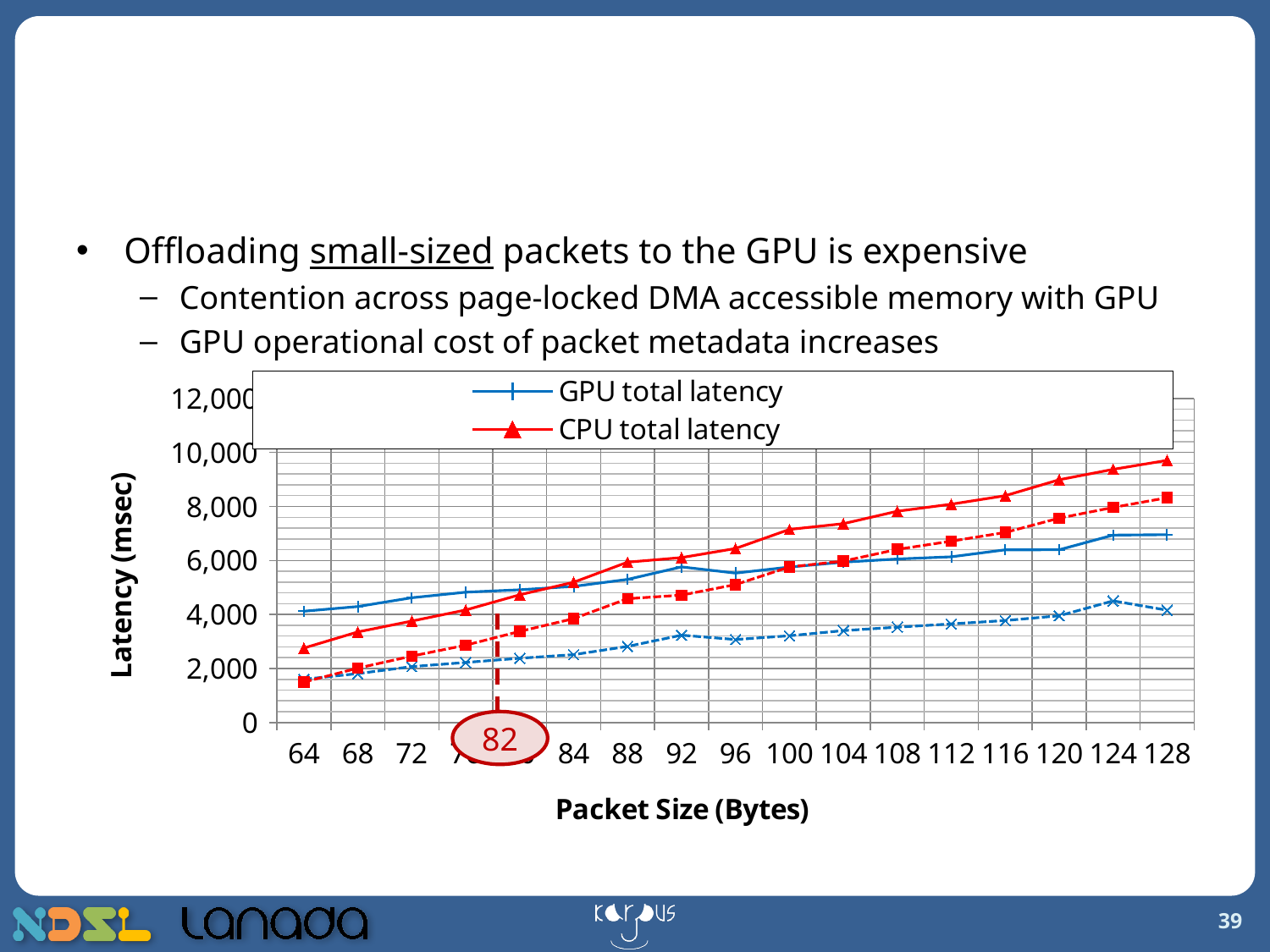
What is the title of the vertical axis? Latency (msec) What is the title of the horizontal axis? Packet Size (Bytes) What kind of chart is shown on the slide? line chart Does CPU total latency rise or fall as packet size increases from 64 to 128 bytes? rise Is the GPU total latency at 128 bytes greater or less than 8,000? less Does GPU total latency rise or fall as packet size increases from 64 to 128 bytes? rise At a packet size of 64 bytes, which is larger: GPU total latency or CPU total latency? GPU total latency At a packet size of 128 bytes, which is larger: GPU total latency or CPU total latency? CPU total latency How many series does the chart's legend list? 2 Is the CPU total latency at 128 bytes greater or less than 8,000? greater Is the CPU total latency at 64 bytes greater or less than 4,000? less